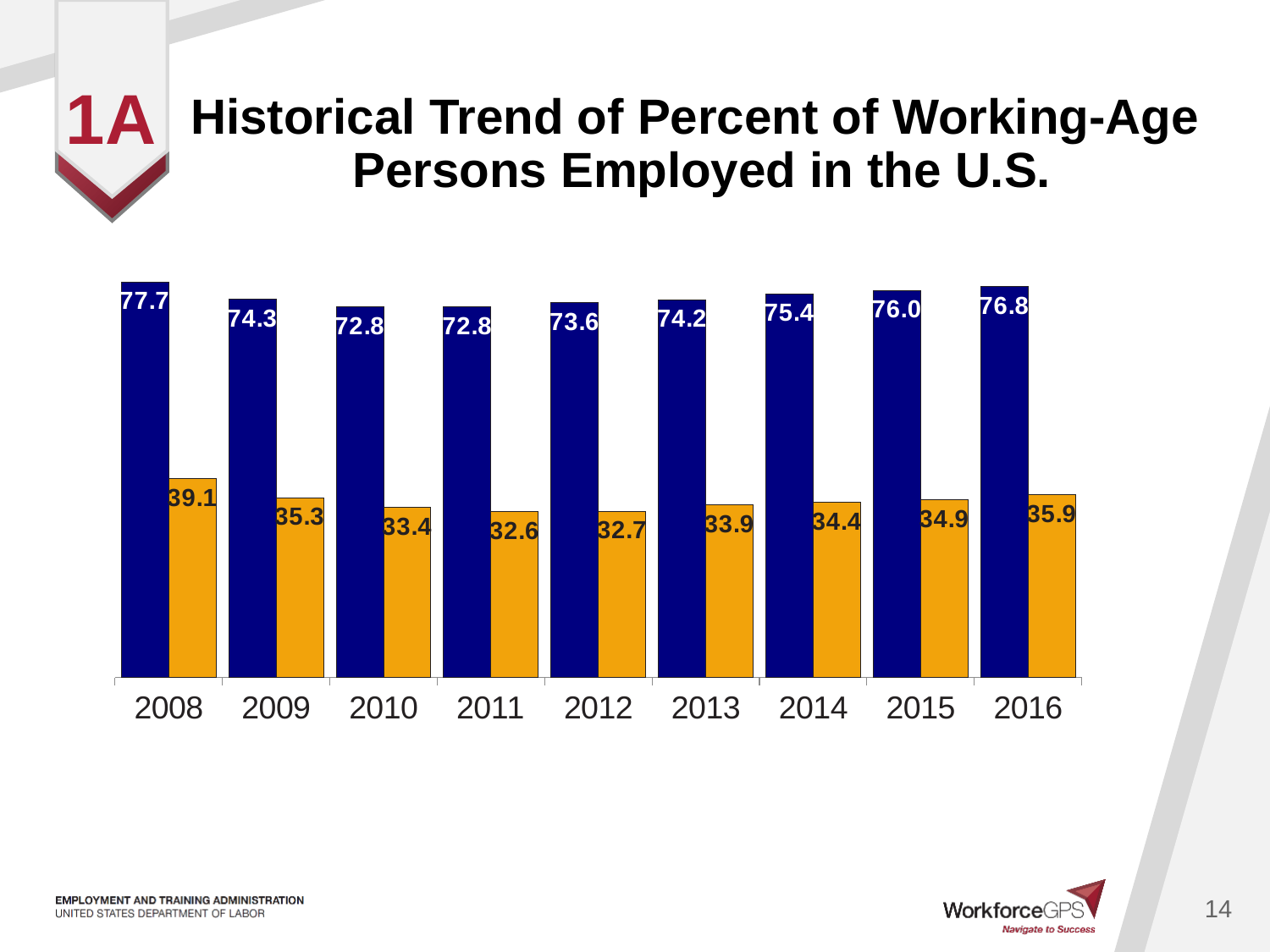
From 2011 to 2016, do the blue bar values rise or fall? rise What is the difference between the blue bar values for 2008 and 2010? 4.9 What is the value of the orange bar for 2011? 32.6 How many years are shown on the x axis? 9 In which year is the orange bar highest? 2008 What is the value of the blue bar for 2008? 77.7 What is the difference between the orange bar values for 2016 and 2012? 3.2 What is the value of the blue bar for 2016? 76.8 What type of chart is shown on the slide? bar chart In which year is the orange bar lowest? 2011 How many series of bars are plotted in the chart? 2 Which is larger, the blue bar for 2013 or the blue bar for 2015? 2015